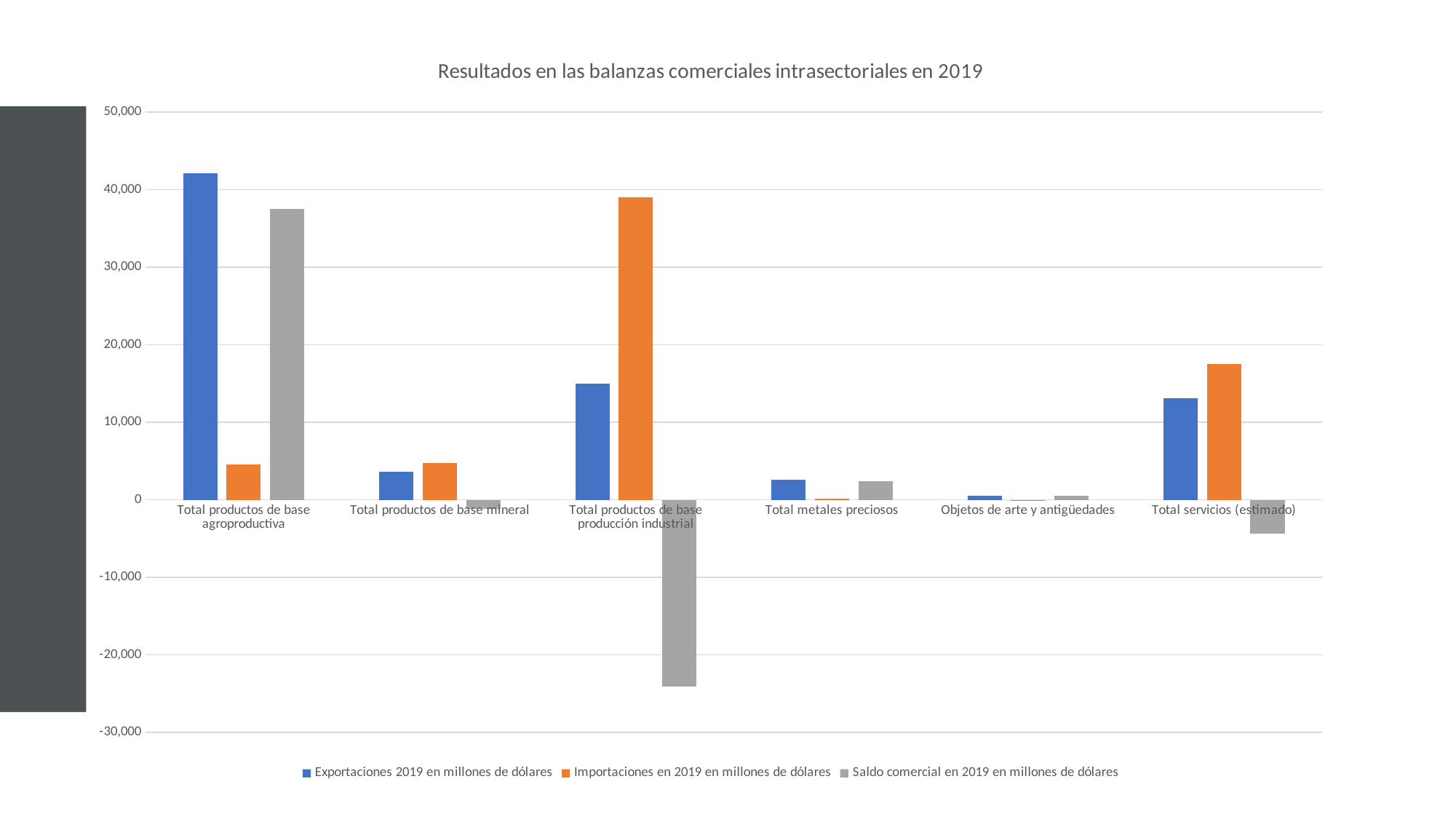
What is the title of the chart? Resultados en las balanzas comerciales intrasectoriales en 2019 Is the Importaciones en 2019 value for Total productos de base producción industrial greater or less than 30,000? greater How many series does the legend list? 3 Which category has the highest value for Importaciones en 2019 en millones de dólares? Total productos de base producción industrial Which category has the lowest value for Saldo comercial en 2019 en millones de dólares? Total productos de base producción industrial For Total servicios (estimado), which is larger: Exportaciones 2019 or Importaciones en 2019? Importaciones en 2019 Which category has the highest value for Exportaciones 2019 en millones de dólares? Total productos de base agroproductiva Is the Saldo comercial en 2019 value for Total productos de base producción industrial greater or less than -20,000? less For Total productos de base agroproductiva, which is larger: Exportaciones 2019 or Importaciones en 2019? Exportaciones 2019 Is the Exportaciones 2019 value for Total productos de base agroproductiva greater or less than 40,000? greater What kind of chart is shown on the slide? bar chart How many categories are shown on the x axis of the chart? 6